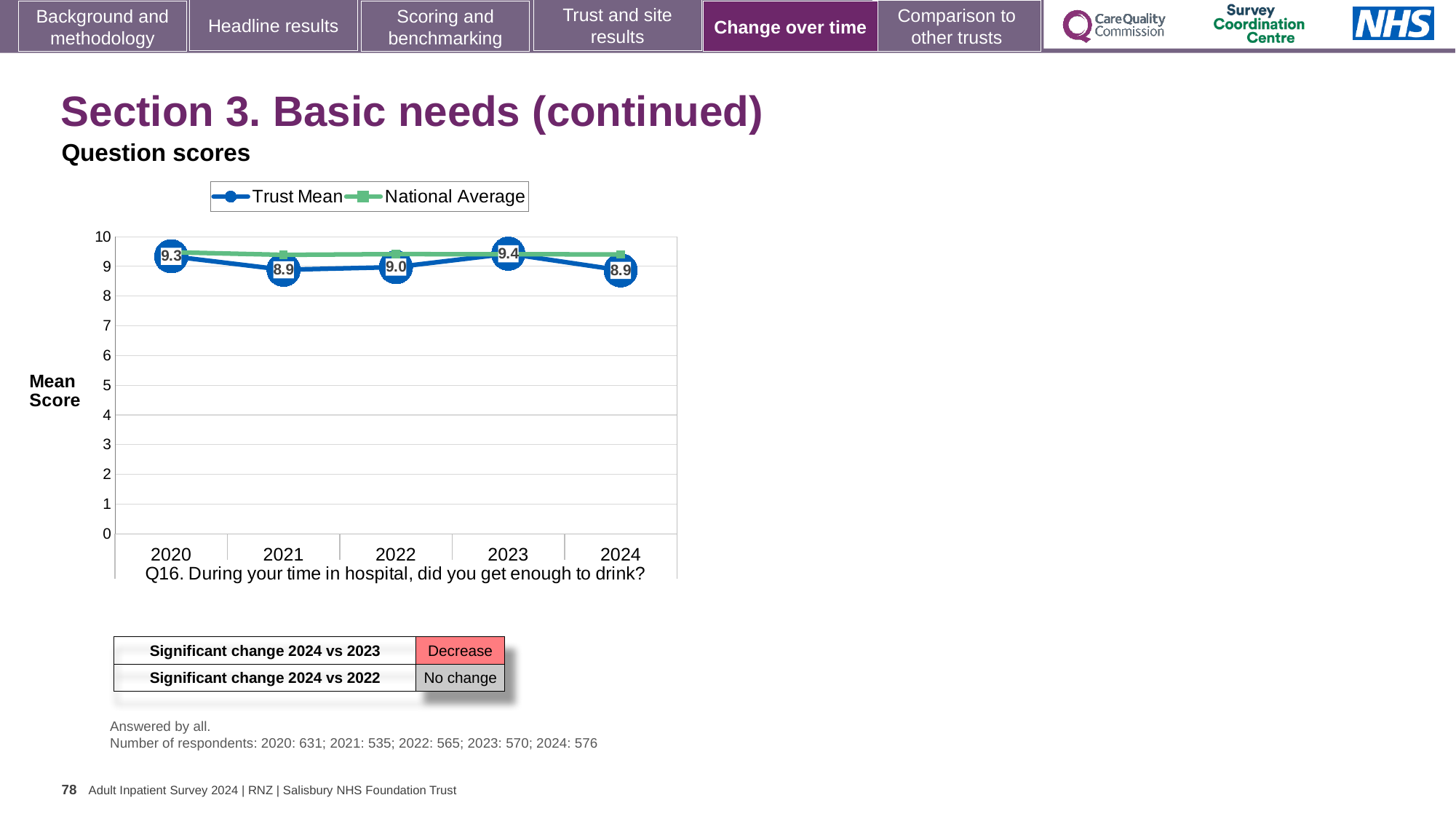
What is the Trust Mean score for 2020? 9.3 What kind of chart is shown on the slide? Line chart How many years are plotted on the x axis? 5 What is the Trust Mean score for 2023? 9.4 How many series does the legend list? 2 Is the National Average value for 2024 greater or less than 8? greater What is the Trust Mean score for 2024? 8.9 Which year has the larger Trust Mean, 2020 or 2021? 2020 What is the difference between the Trust Mean in 2023 and in 2024? 0.5 What is the lowest Trust Mean value shown on the chart? 8.9 Does the Trust Mean rise or fall from 2023 to 2024? Fall In which year is the Trust Mean highest? 2023